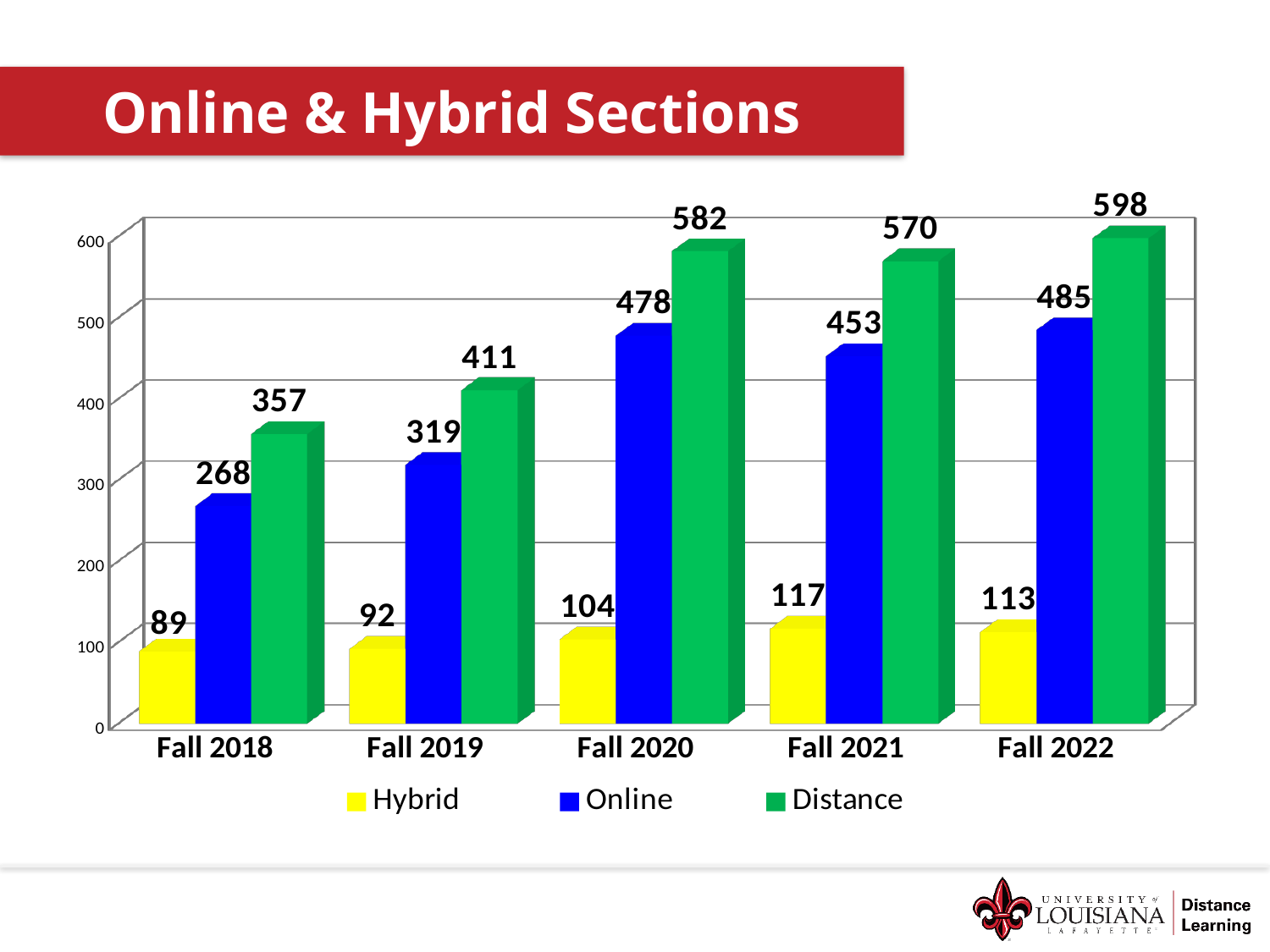
Which semester has the highest Distance value? Fall 2022 What is the value for Hybrid in Fall 2018? 89 What is the value for Distance in Fall 2021? 570 Which is larger, the Hybrid value in Fall 2021 or the Hybrid value in Fall 2019? Fall 2021 What colour represents the Hybrid series in the legend? Yellow Which semester has the lowest Online value? Fall 2018 How many semesters are shown on the x axis? 5 What is the difference between the Distance and Online values in Fall 2022? 113 What kind of chart is shown on the slide? Bar chart How many series does the legend list? 3 What is the value for Online in Fall 2020? 478 Does the Distance value rise or fall from Fall 2018 to Fall 2020? Rise